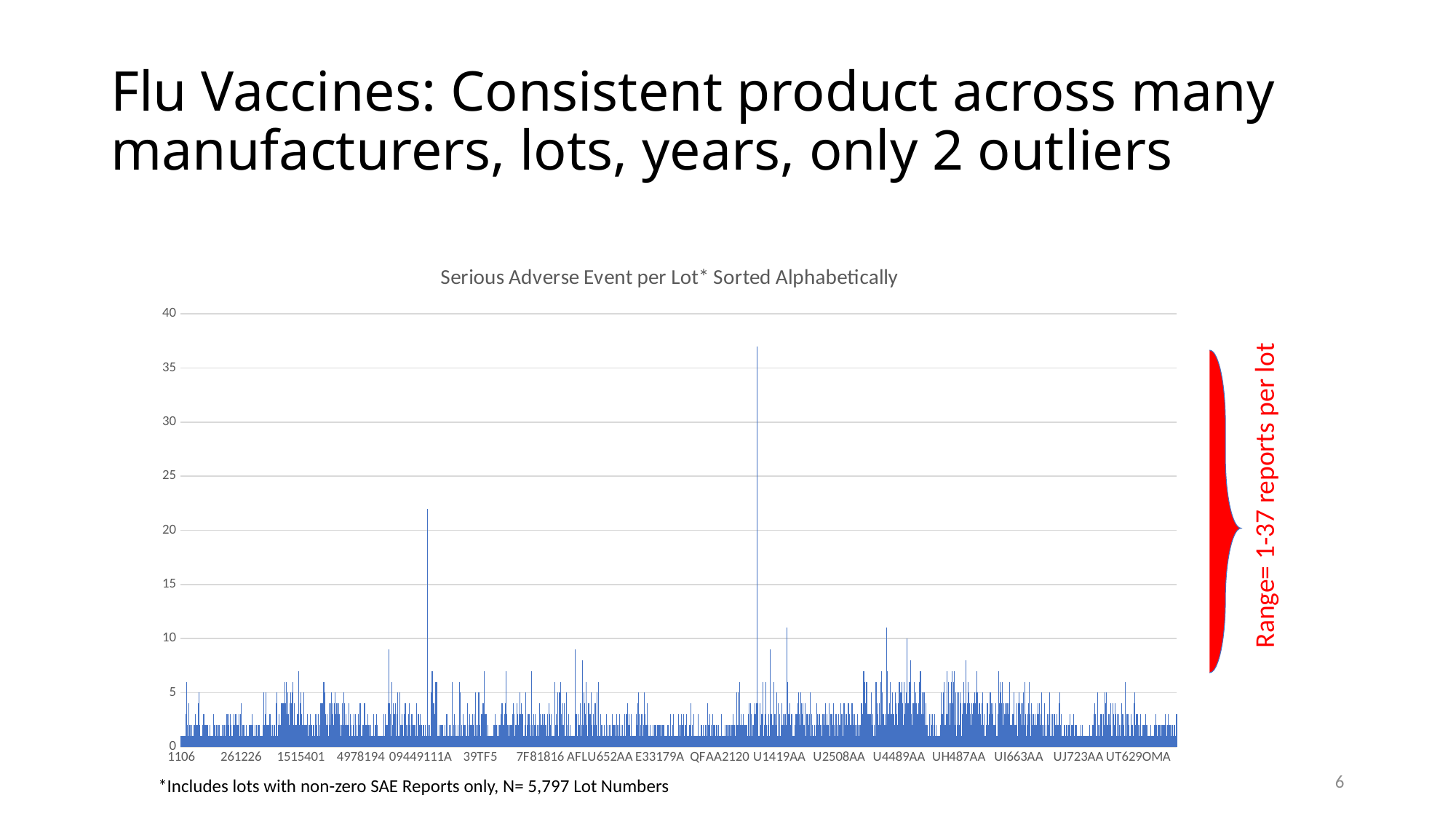
How many lot numbers are included in the chart, according to the footnote? 5,797 Which of the two tallest bars is larger: the one near lot U1419AA or the one near lot 09449111A? the one near U1419AA What is the title of the chart? Serious Adverse Event per Lot* Sorted Alphabetically According to the annotation beside the chart, what is the range of reports per lot? 1-37 reports per lot Is the value of the second-tallest bar in the chart greater or less than 20? greater What kind of chart is shown on the slide? bar chart How many outliers does the slide title say there are? 2 What is the highest value shown on the y-axis of the chart? 40 Is the value of the second-tallest bar in the chart greater or less than 25? less Is the value of the tallest bar in the chart greater or less than 35? greater What is the highest number of serious adverse event reports for a single lot, according to the slide? 37 What is the lowest number of serious adverse event reports for a lot included in the chart? 1